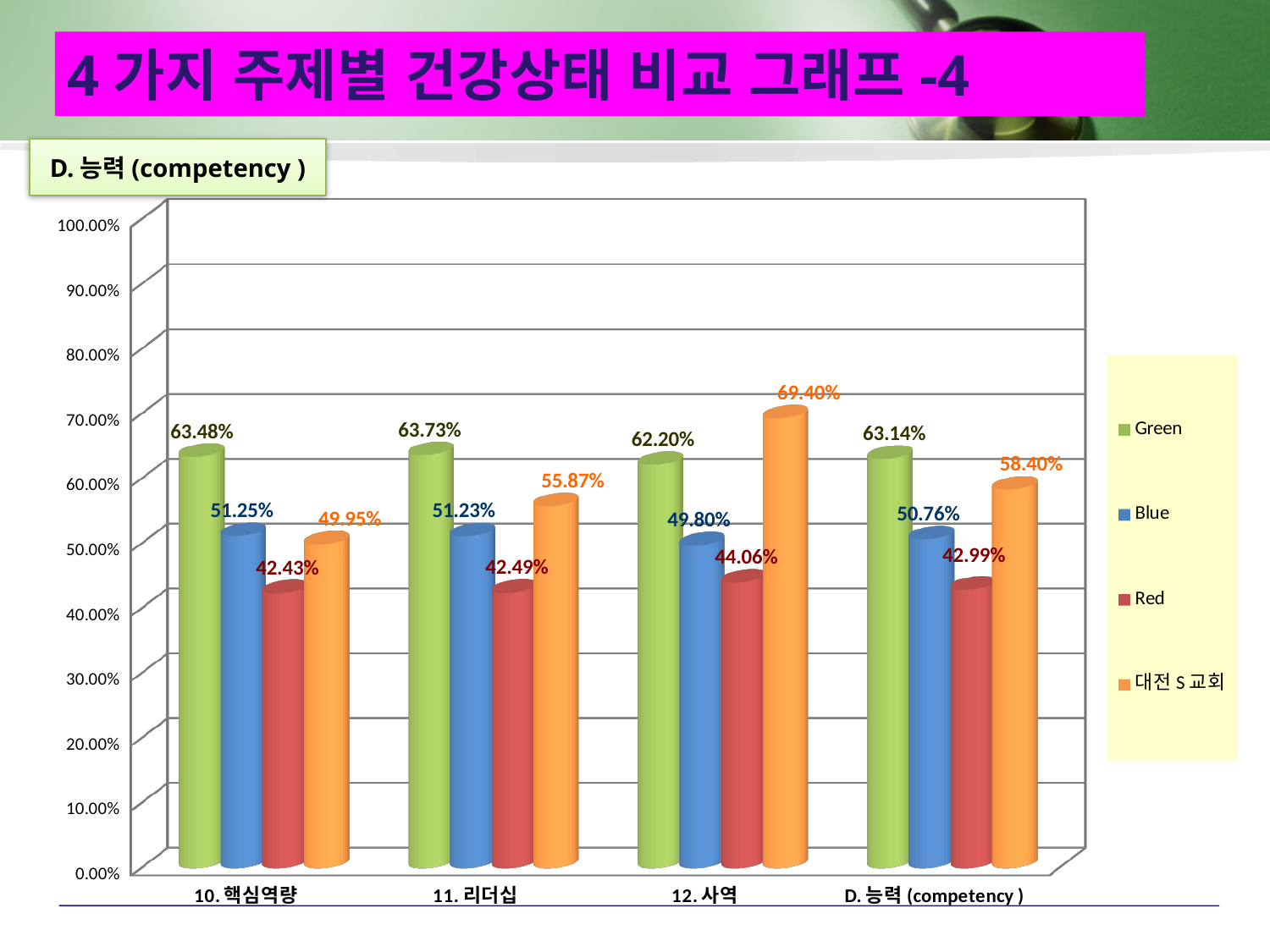
What is the value of the Blue series for D. 능력 (competency )? 50.76% Which category has the highest value for the 대전 S 교회 series? 12. 사역 Which category has the lowest value for the Red series? 10. 핵심역량 For 11. 리더십, which is larger: the Green value or the 대전 S 교회 value? Green How many series does the legend list? 4 What kind of chart is shown on the slide? Bar chart What is the value of the Red series for 11. 리더십? 42.49% How many categories are shown on the x axis? 4 What is the difference between the 대전 S 교회 value and the Red value for 12. 사역? 25.34% What is the value of the Green series for 10. 핵심역량? 63.48% What is the last entry listed in the chart legend? 대전 S 교회 What is the value of the 대전 S 교회 series for 12. 사역? 69.40%